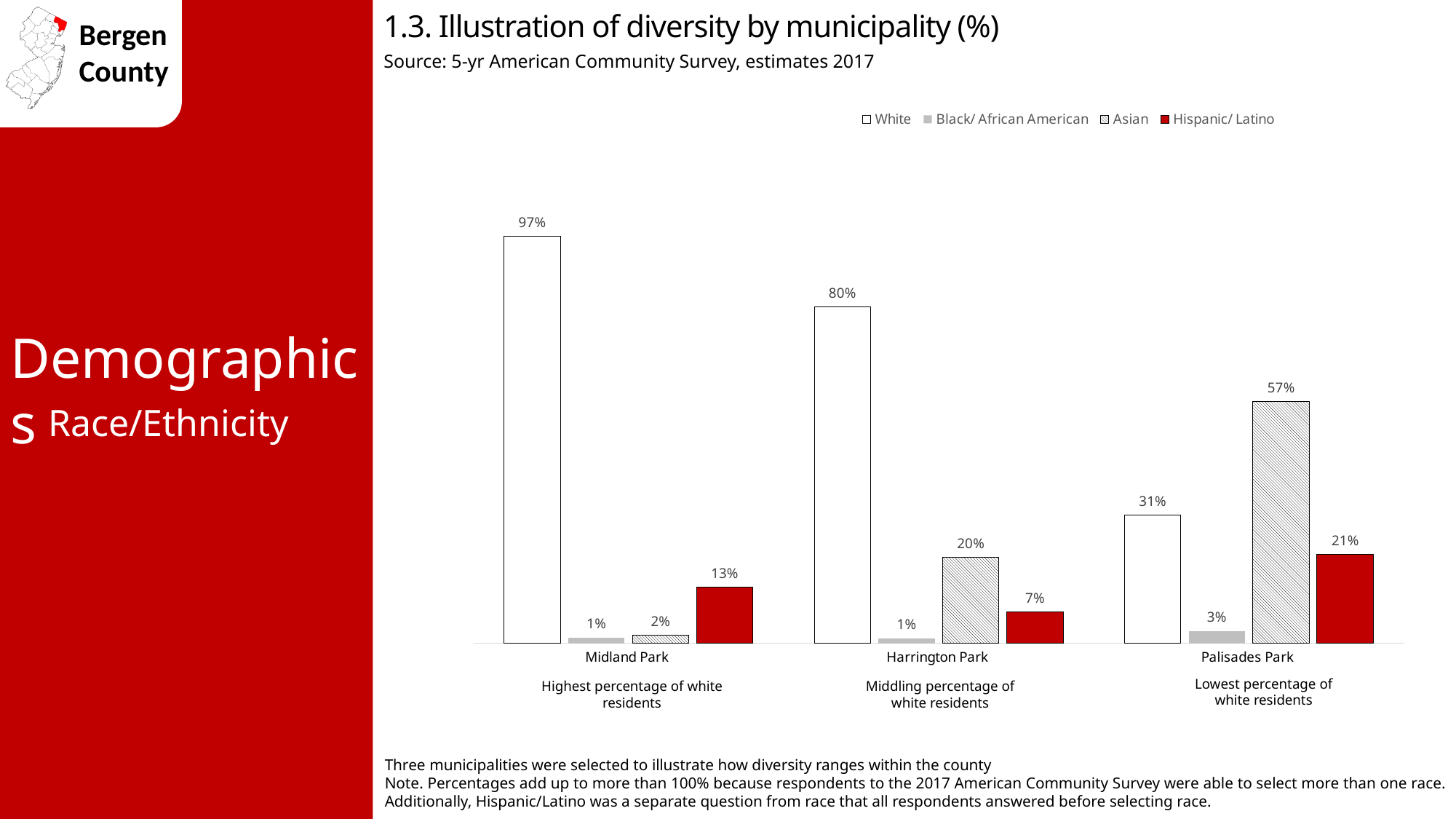
Which municipality has the highest White percentage? Midland Park What is the Black/ African American percentage for Palisades Park? 3% Which is larger in Palisades Park: the Asian percentage or the White percentage? Asian What kind of chart is shown on the slide? Bar chart What is the Hispanic/ Latino percentage for Harrington Park? 7% What is the difference between the White percentage in Midland Park and in Harrington Park? 17% What is the Asian percentage for Palisades Park? 57% How many municipalities are shown on the chart? 3 How many series does the legend list? 4 What is the White percentage for Midland Park? 97% Which municipality has the lowest Hispanic/ Latino percentage? Harrington Park Which series is shown in red on the chart? Hispanic/ Latino